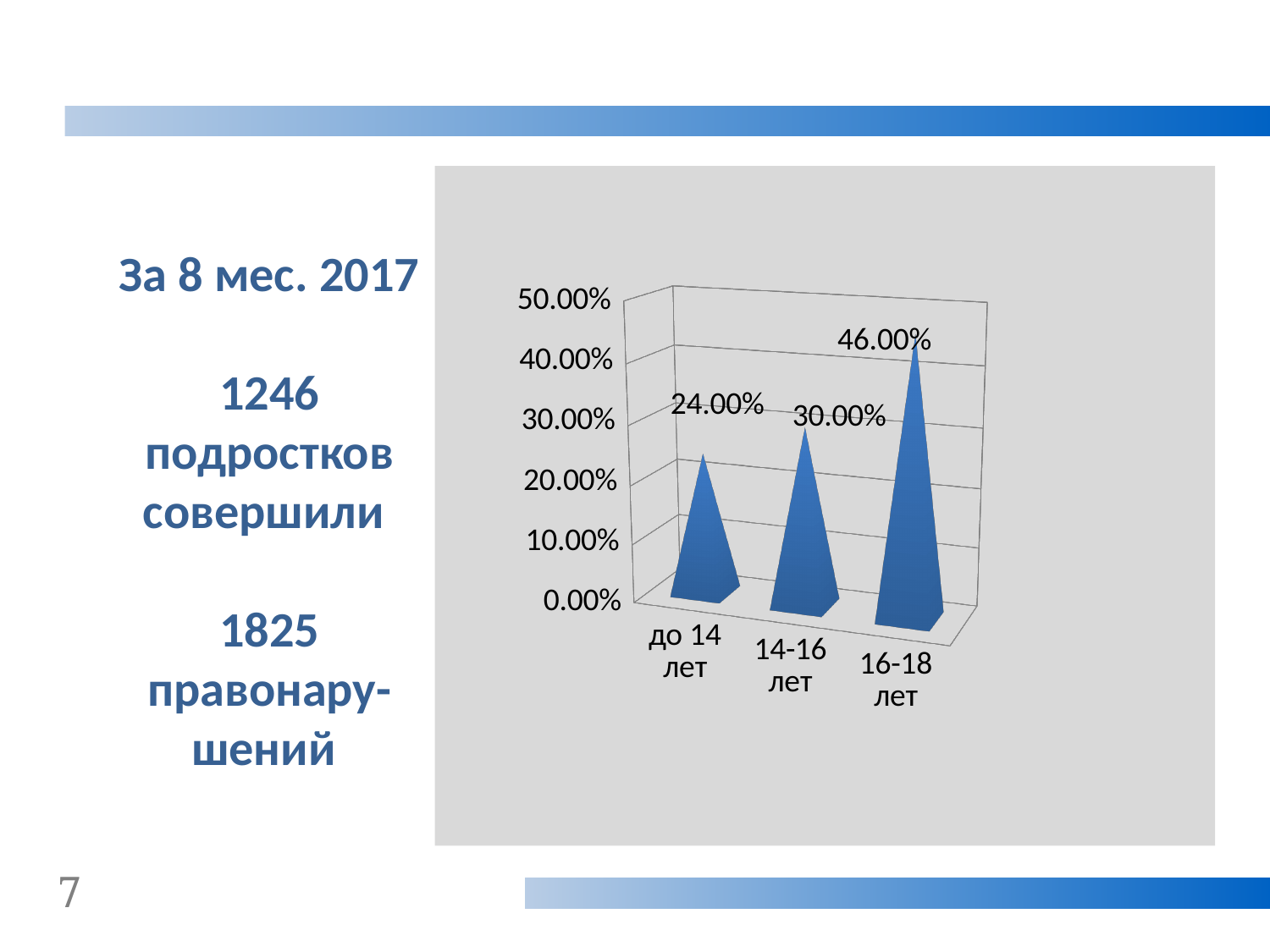
What is the value for the "14-16 лет" category? 30.00% Which is larger, the value for "14-16 лет" or the value for "16-18 лет"? 16-18 лет Which age category has the highest value? 16-18 лет Which age category has the lowest value? до 14 лет What is the value for the "до 14 лет" category? 24.00% How many age categories are shown on the chart? 3 What is the difference between the values for "16-18 лет" and "до 14 лет"? 22.00% What is the difference between the values for "14-16 лет" and "до 14 лет"? 6.00% Is the value for "16-18 лет" greater or less than 40.00%? greater What kind of chart is shown on the slide? bar chart What is the value for the "16-18 лет" category? 46.00% Do the values rise or fall from left to right across the age categories? rise